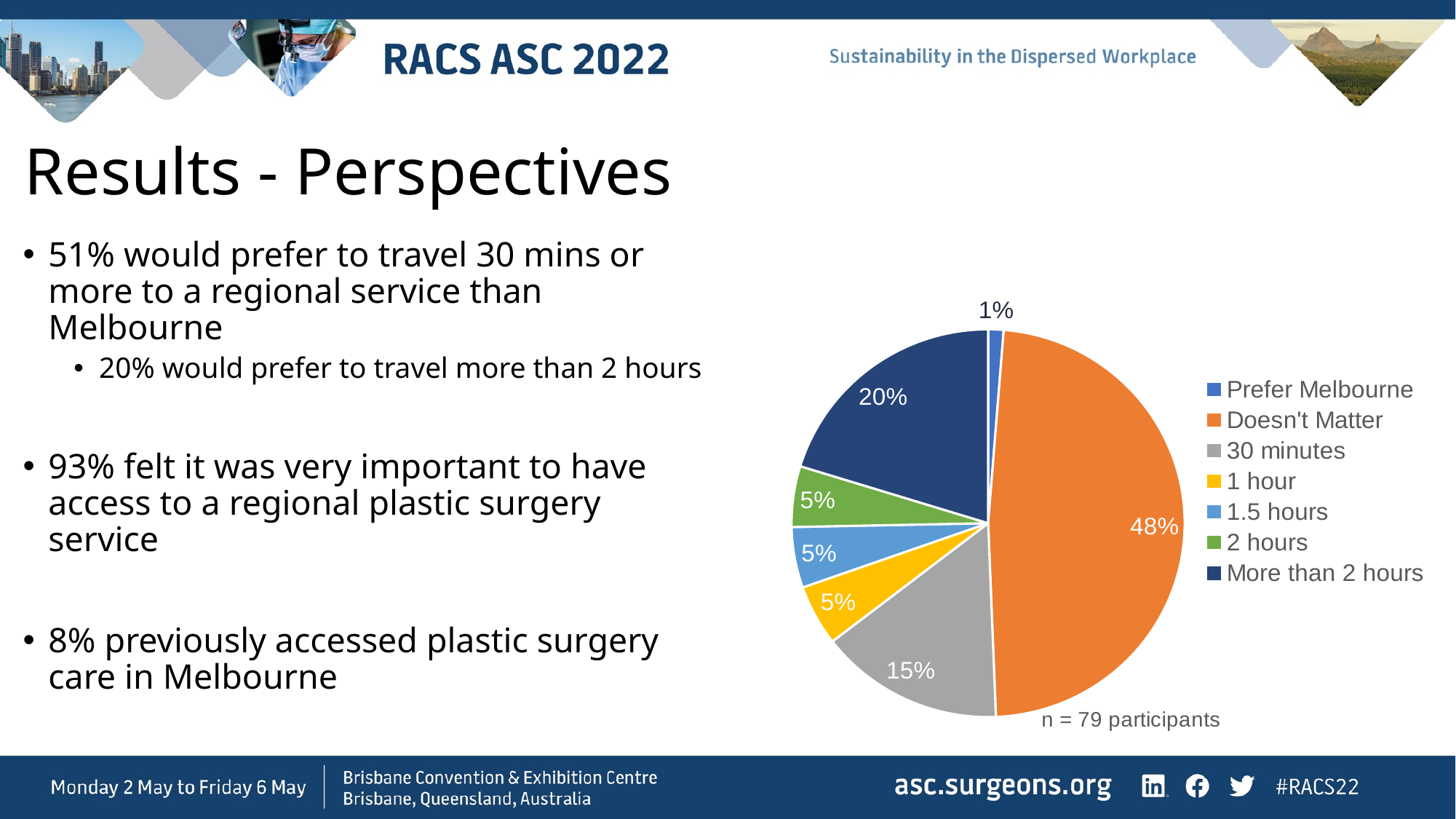
What share of the pie does "Prefer Melbourne" take? 1% How many participants does the chart note say were surveyed? 79 What share of the pie does "30 minutes" take? 15% What is the difference in percentage points between "Doesn't Matter" and "More than 2 hours"? 28 What share of the pie does "Doesn't Matter" take? 48% How many categories does the pie chart have? 7 What colour is the "More than 2 hours" slice in the pie chart? dark blue Which category has the smallest slice of the pie? Prefer Melbourne Which is larger, the slice for "30 minutes" or the slice for "1 hour"? 30 minutes Which category has the largest slice of the pie? Doesn't Matter What kind of chart is shown on the slide? pie chart